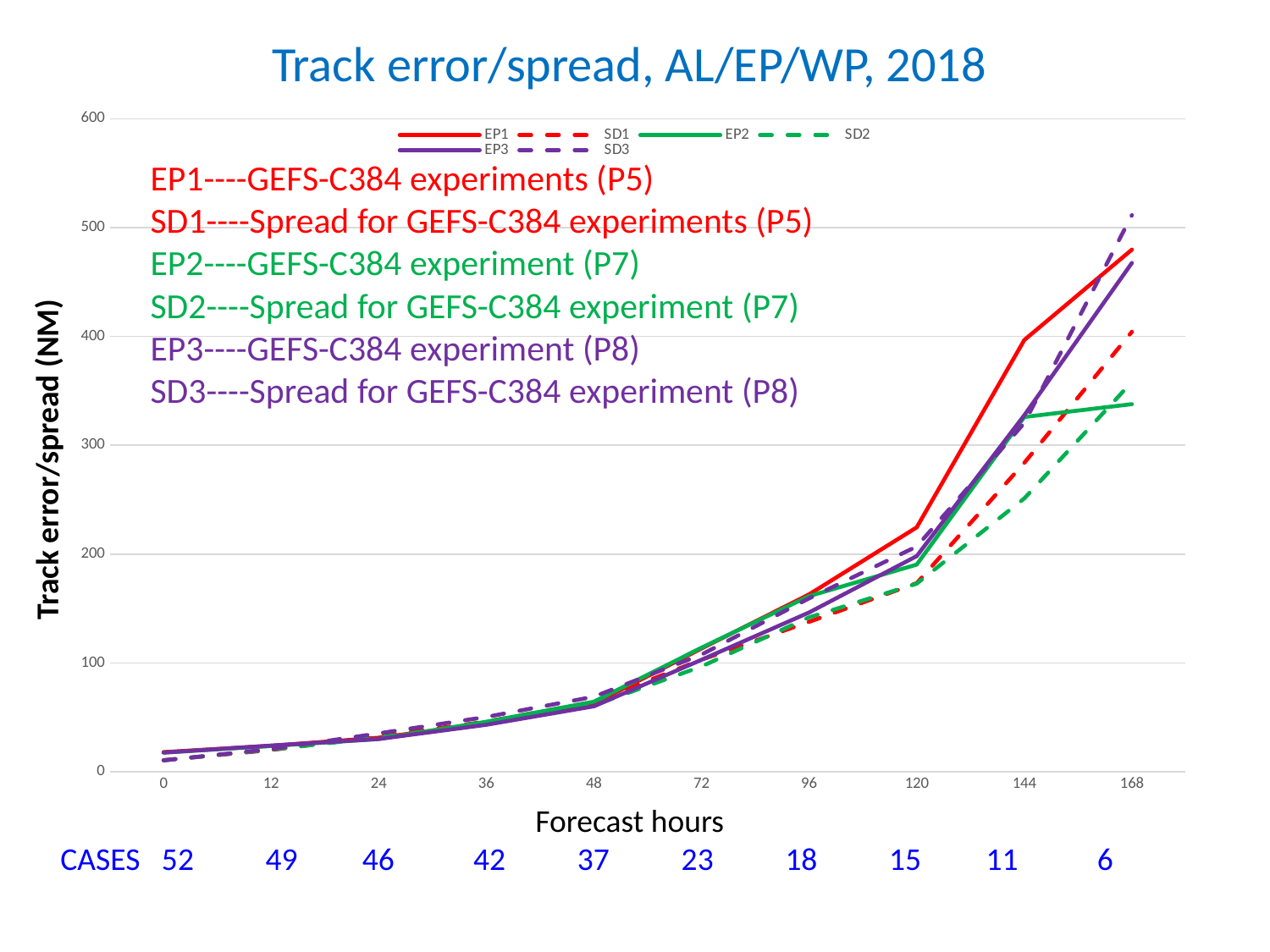
How many forecast-hour points are shown along the x axis? 10 Is the EP2 value at 168 forecast hours greater or less than 400? less Do the EP1 values rise or fall as forecast hours increase from 0 to 168? rise What is the label of the chart's vertical axis? Track error/spread (NM) How many series does the chart's legend list? 6 Which series has the highest value at 168 forecast hours? SD3 Is the EP1 value at 120 forecast hours greater or less than 200? greater Is the EP1 value at 144 forecast hours greater or less than 300? greater At 144 forecast hours, which is larger, EP1 or SD1? EP1 What kind of chart is shown on the slide? line chart What is the title of the chart? Track error/spread, AL/EP/WP, 2018